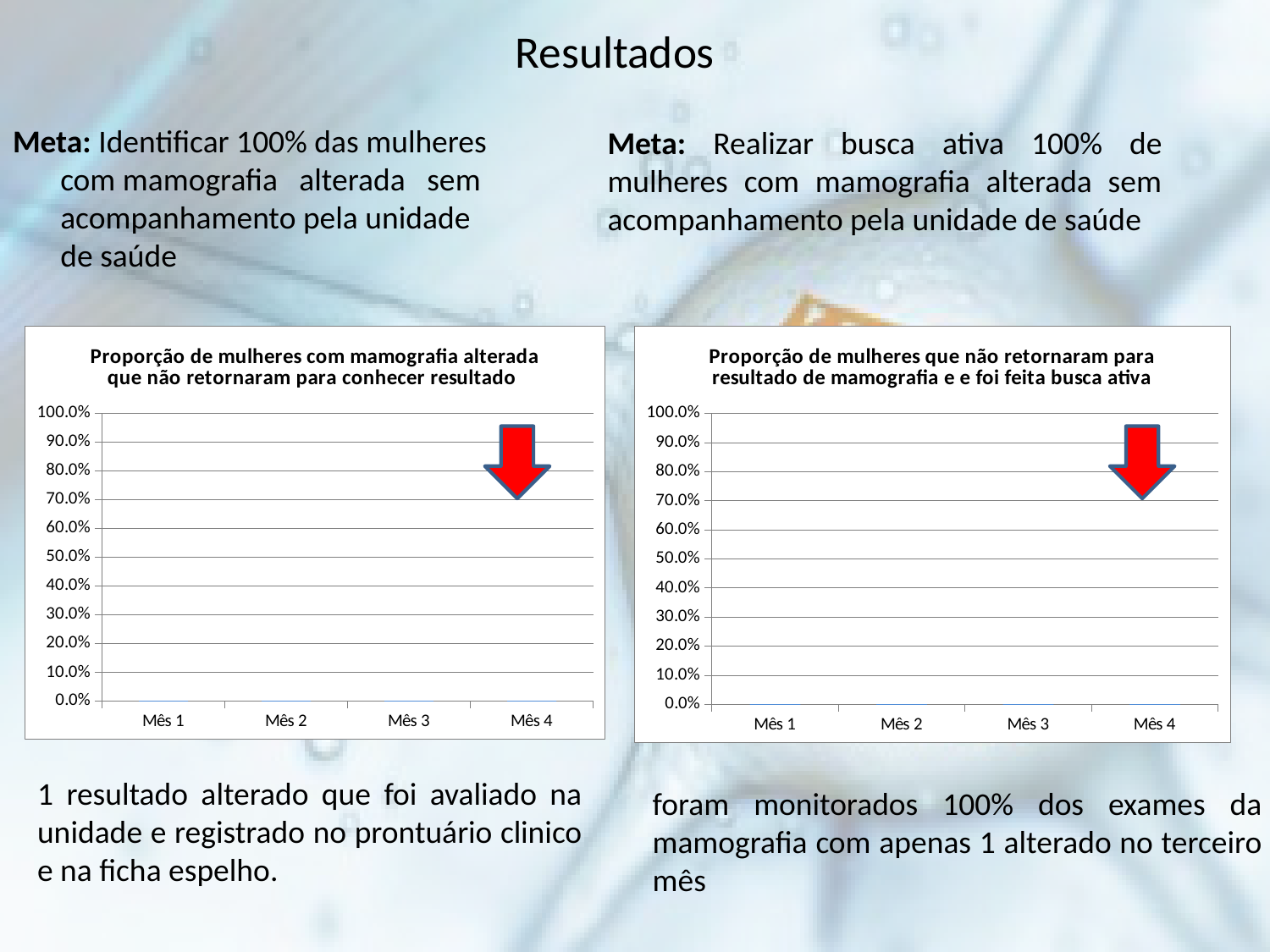
What is the label of the first category on the x axis of the right chart? Mês 1 What kind of chart is the right chart, 'Proporção de mulheres que não retornaram para resultado de mamografia e e foi feita busca ativa'? bar chart What kind of chart is the left chart, 'Proporção de mulheres com mamografia alterada que não retornaram para conhecer resultado'? bar chart What is the highest tick shown on the y axis of the left chart? 100.0% In the right chart, is the value for Mês 3 greater or less than 30.0%? less In the left chart, is the value for Mês 2 greater or less than 20.0%? less In the left chart, is the value for Mês 4 greater or less than 50.0%? less In the left chart, what is the value for Mês 3? 0.0% In the right chart, what is the value for Mês 4? 0.0% How many categories are shown on the x axis of the left chart? 4 How many categories are shown on the x axis of the right chart? 4